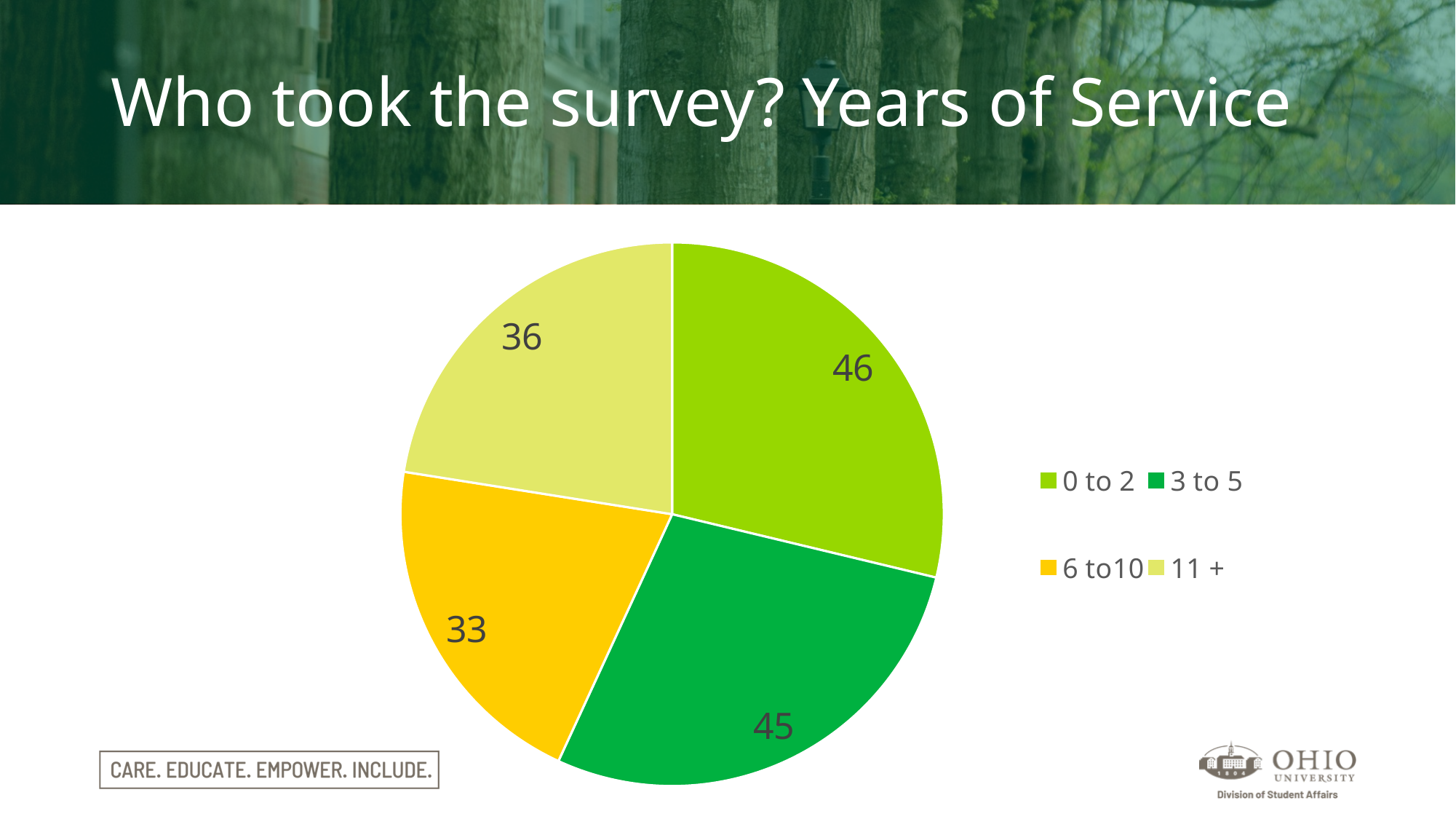
Which years-of-service category has the smallest slice? 6 to10 What kind of chart is shown on the slide? Pie chart What is the title of the slide containing the chart? Who took the survey? Years of Service Which years-of-service category has the largest slice? 0 to 2 What is the value for the 0 to 2 slice? 46 What share of the pie does the 11 + slice represent? 22.5% What is the value for the 6 to10 slice? 33 Which is larger, the 11 + slice or the 6 to10 slice? 11 + What is the value for the 3 to 5 slice? 45 How many categories does the pie chart show? 4 What is the value for the 11 + slice? 36 What is the difference between the 0 to 2 value and the 6 to10 value? 13